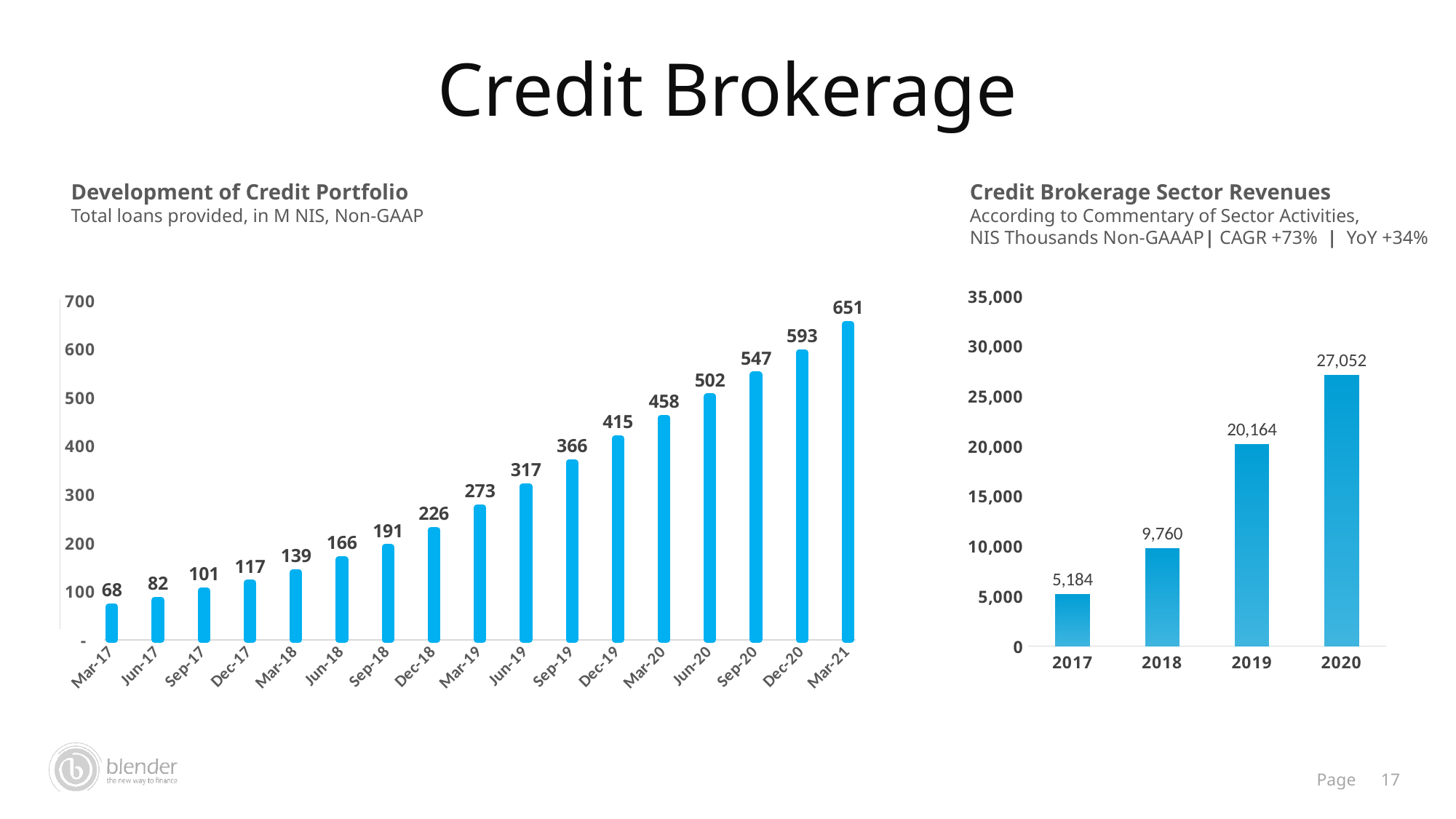
In the 'Credit Brokerage Sector Revenues' chart, how many years are shown? 4 In the 'Development of Credit Portfolio' chart, which period has the lowest value? Mar-17 What kind of chart is the 'Development of Credit Portfolio' chart? bar chart In the 'Development of Credit Portfolio' chart, do the values rise or fall from Mar-17 to Mar-21? rise In the 'Development of Credit Portfolio' chart, what is the value for Mar-21? 651 In the 'Development of Credit Portfolio' chart, what is the value for Dec-18? 226 In the 'Development of Credit Portfolio' chart, how many periods are shown on the x axis? 17 In the 'Credit Brokerage Sector Revenues' chart, what is the difference between the values for 2018 and 2017? 4,576 In the 'Development of Credit Portfolio' chart, what is the difference between the values for Mar-21 and Dec-20? 58 In the 'Credit Brokerage Sector Revenues' chart, which year has the highest value? 2020 In the 'Credit Brokerage Sector Revenues' chart, what is the value for 2019? 20,164 In the 'Credit Brokerage Sector Revenues' chart, is the value for 2020 greater or less than 25,000? greater